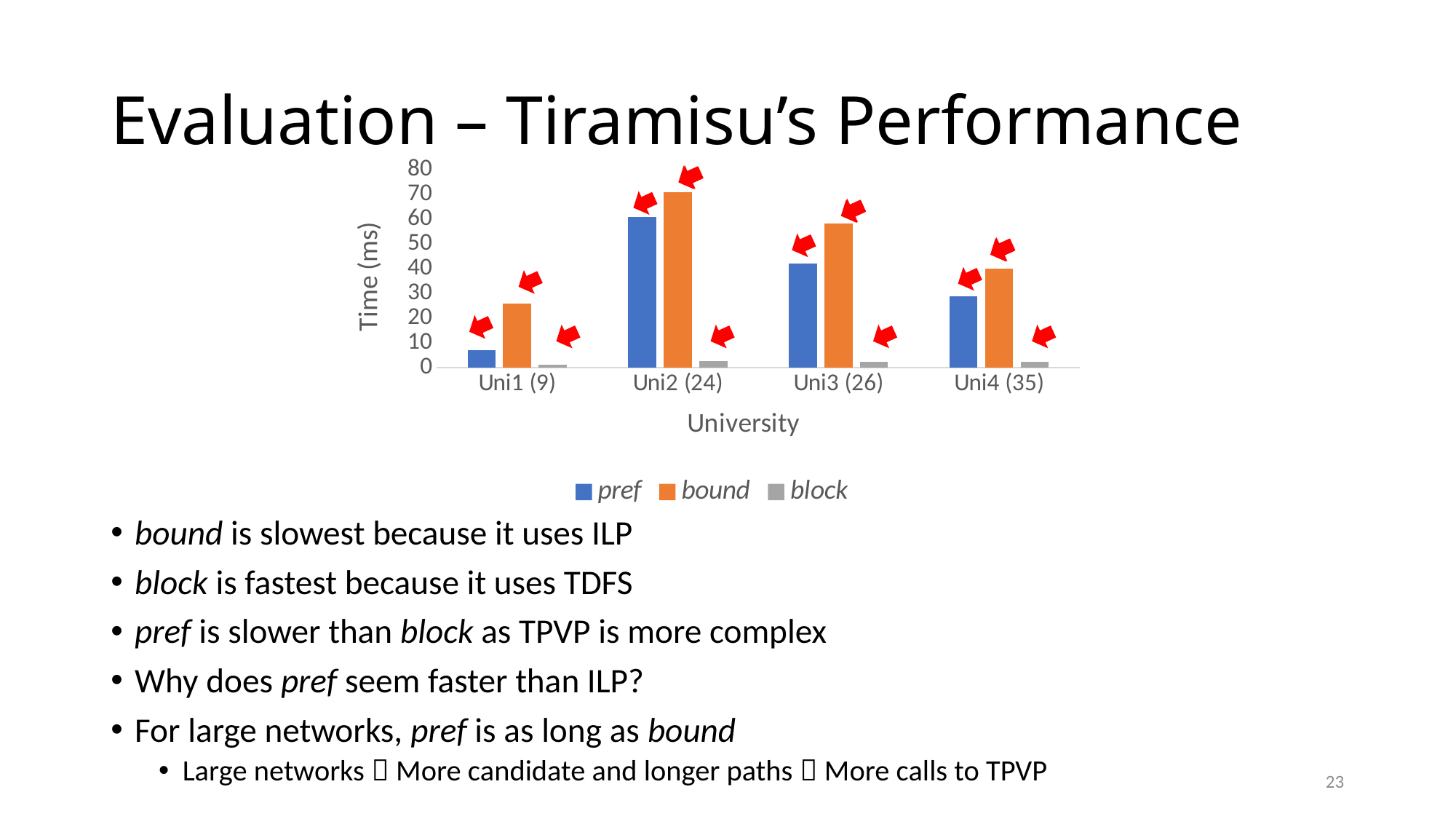
Which series is shown in orange in the legend? bound Is the bound value for Uni2 (24) greater or less than 60? greater Which university has the lowest pref time? Uni1 (9) Which university has the highest bound time? Uni2 (24) How many series does the legend list? 3 For Uni3 (26), which is larger, the pref time or the bound time? bound Is the pref value for Uni3 (26) greater or less than 30? greater How many university categories are shown on the x axis? 4 Is the bound value for Uni4 (35) greater or less than 50? less What kind of chart is shown on the slide? bar chart What is the label of the y axis? Time (ms)